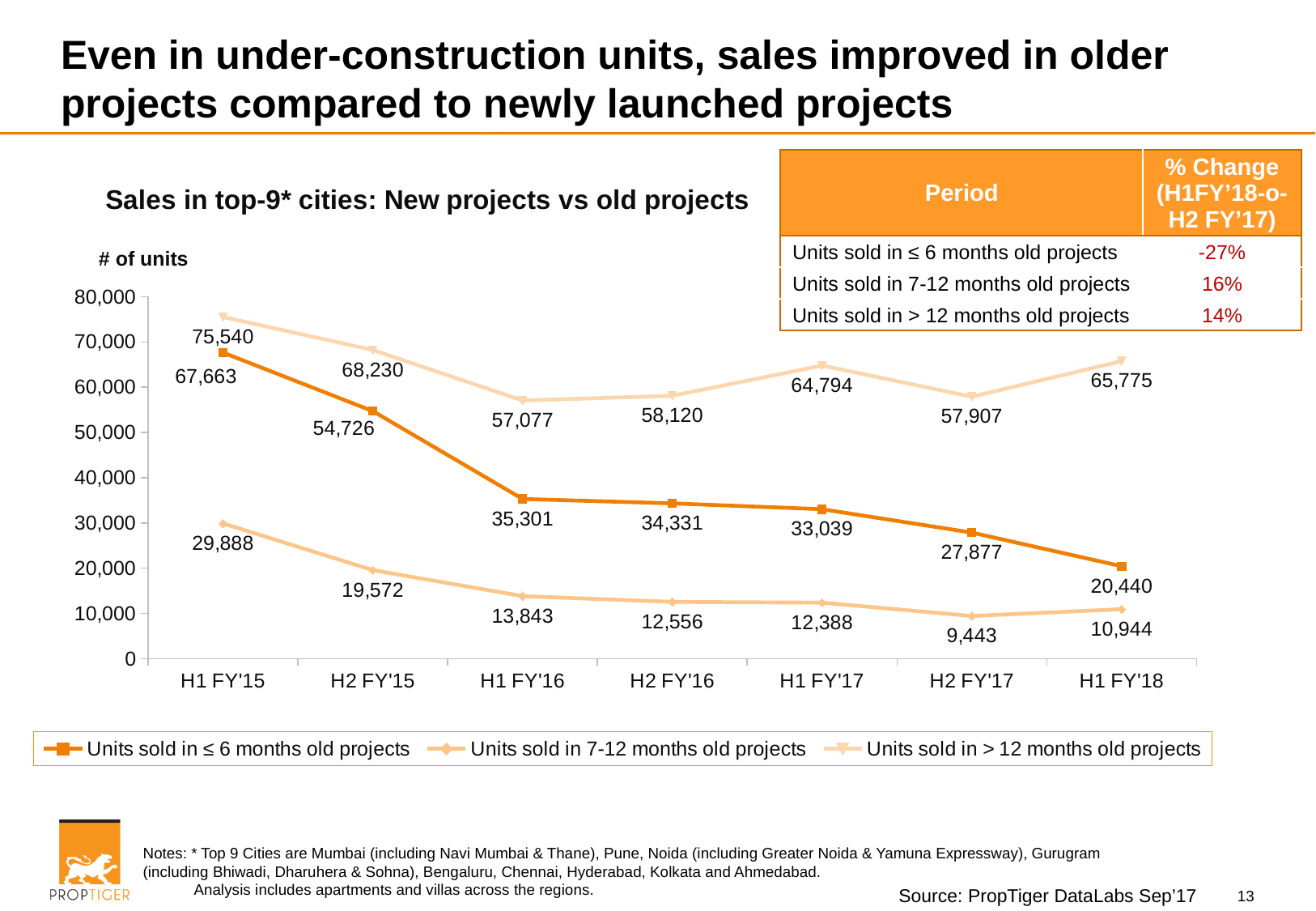
What is the value for units sold in > 12 months old projects in H1 FY'17? 64,794 What kind of chart is shown on the slide? Line chart By how much did units sold in ≤ 6 months old projects fall from H1 FY'15 to H1 FY'18? 47,223 What is the difference between units sold in > 12 months old projects in H1 FY'18 and H2 FY'17? 7,868 In H2 FY'16, which series had more units sold: ≤ 6 months old projects or 7-12 months old projects? Units sold in ≤ 6 months old projects How many series does the chart's legend list? 3 How many units were sold in 7-12 months old projects in H2 FY'17? 9,443 How many periods are shown on the x axis of the chart? 7 Do units sold in ≤ 6 months old projects rise or fall from H1 FY'15 to H1 FY'18? Fall In which period were units sold in 7-12 months old projects the lowest? H2 FY'17 How many units were sold in ≤ 6 months old projects in H1 FY'18? 20,440 In which period were units sold in > 12 months old projects the highest? H1 FY'15